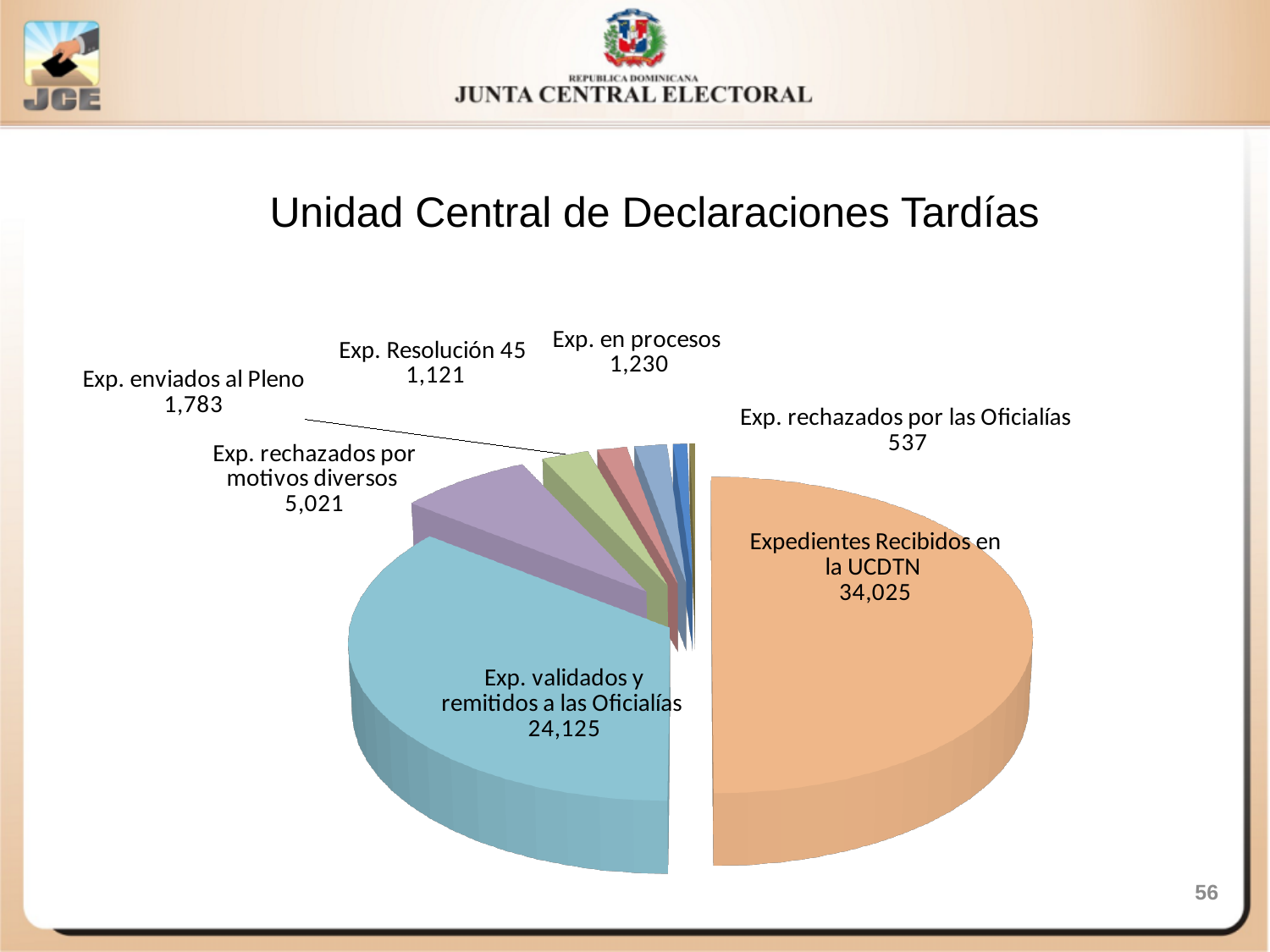
What is the value for Exp. validados y remitidos a las Oficialías? 24,125 What type of chart is shown on the slide? Pie chart What is the value for Exp. rechazados por motivos diversos? 5,021 Which is larger, Exp. en procesos or Exp. Resolución 45? Exp. en procesos What is the value for Exp. rechazados por las Oficialías? 537 What is the title of the slide containing the chart? Unidad Central de Declaraciones Tardías What is the value for Expedientes Recibidos en la UCDTN? 34,025 How many slices does the pie chart have? 8 Which category has the largest slice of the pie? Expedientes Recibidos en la UCDTN What is the difference between Expedientes Recibidos en la UCDTN and Exp. validados y remitidos a las Oficialías? 9,900 What is the difference between Exp. enviados al Pleno and Exp. rechazados por las Oficialías? 1,246